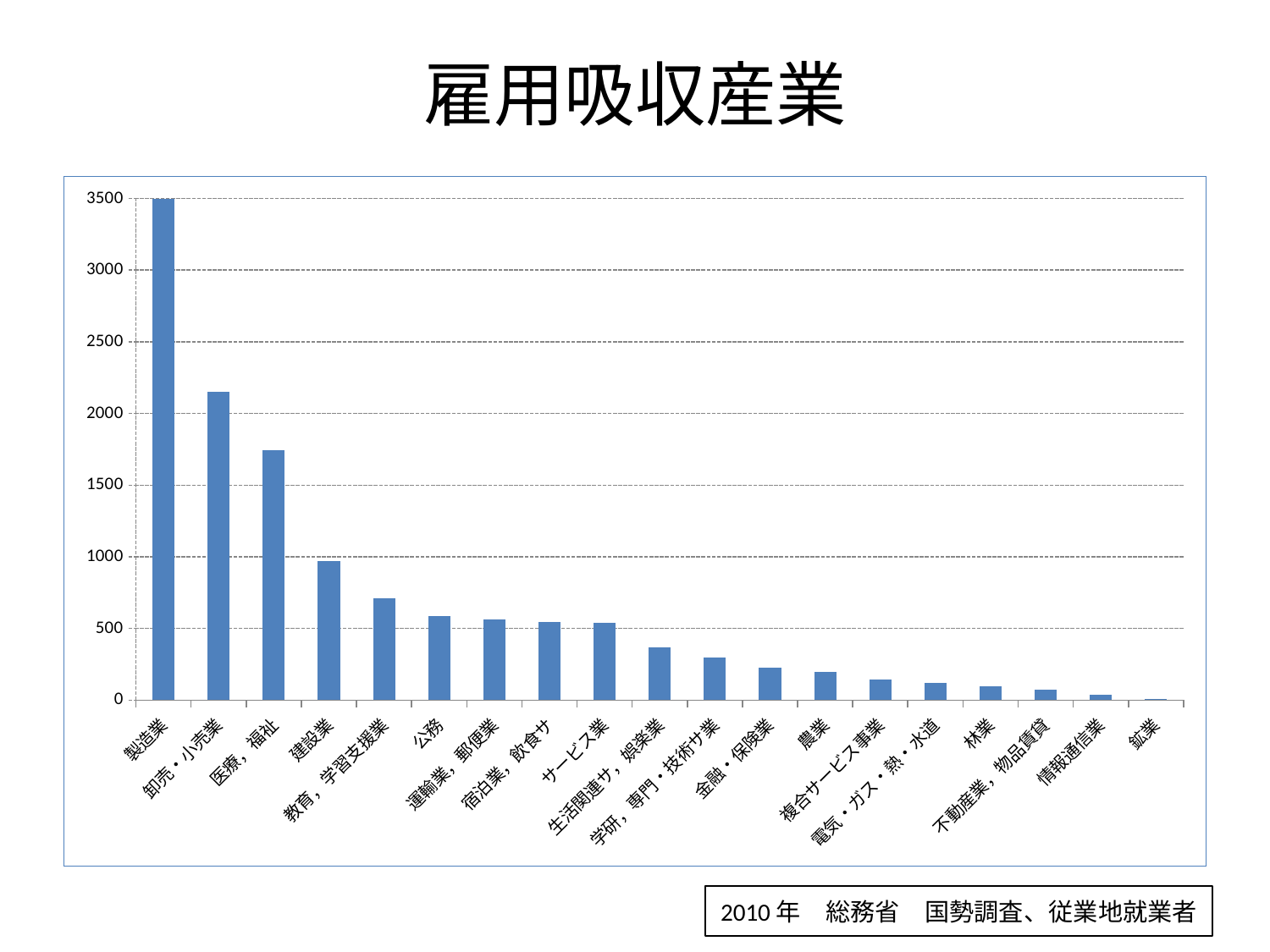
Which is larger, the value for 生活関連サ，娯楽業 or the value for 林業? 生活関連サ，娯楽業 Is the value for 農業 greater or less than 500? less What is the title of the slide? 雇用吸収産業 Which is larger, the value for 医療，福祉 or the value for 建設業? 医療，福祉 How many industry categories are plotted in the chart? 19 Is the value for 医療，福祉 greater or less than 1500? greater Do the values rise or fall moving from left to right along the x axis? fall What kind of chart is shown on the slide? bar chart Is the value for 建設業 greater or less than 1000? less Which industry has the highest value in the chart? 製造業 Which industry has the lowest value in the chart? 鉱業